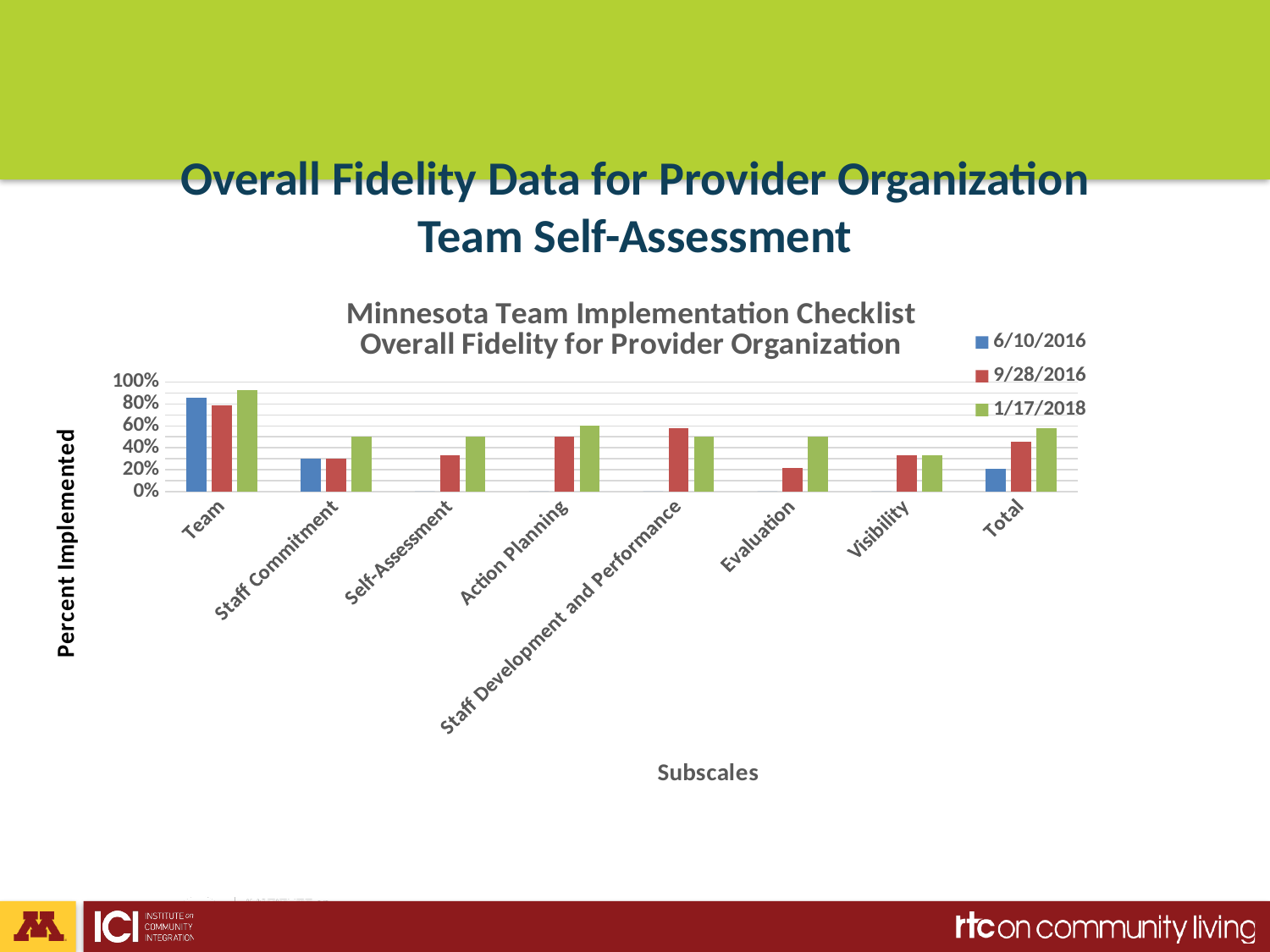
For Total, which series has the larger value: 9/28/2016 or 1/17/2018? 1/17/2018 For Staff Commitment, which series has the larger value: 6/10/2016 or 1/17/2018? 1/17/2018 Which subscale has the highest value for the 1/17/2018 series? Team What is the label of the y axis? Percent Implemented Is the 1/17/2018 value for Team greater or less than 80%? greater How many series does the legend list? 3 Is the 6/10/2016 value for Total greater or less than 40%? less Which subscale has the highest value for the 9/28/2016 series? Team What kind of chart is shown on the slide? bar chart How many subscale categories are shown on the x axis? 8 What is the label of the x axis? Subscales Is the 9/28/2016 value for Evaluation greater or less than 40%? less